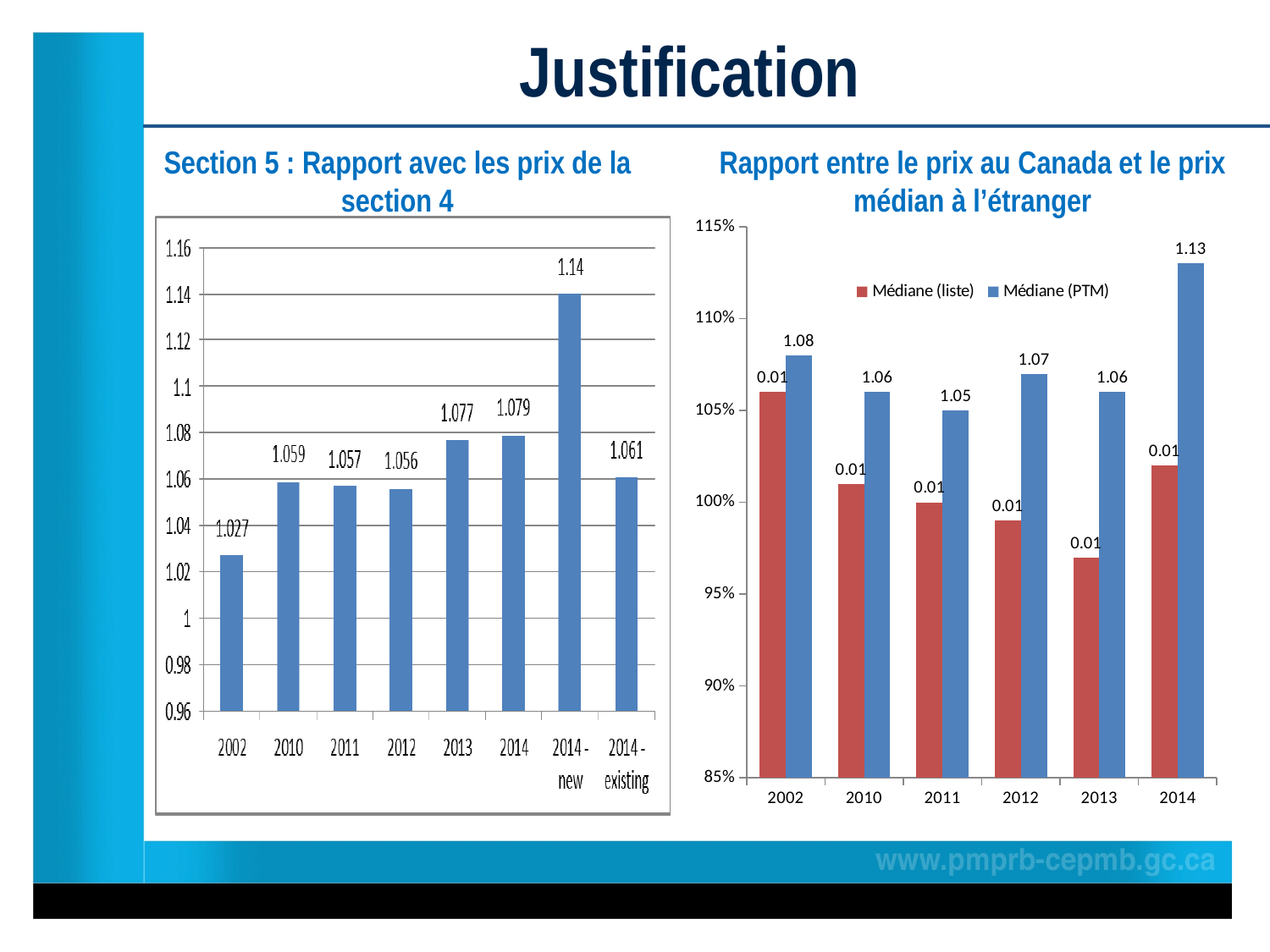
In the left chart 'Section 5 : Rapport avec les prix de la section 4', how many categories are shown on the x axis? 8 In the right chart 'Rapport entre le prix au Canada et le prix médian à l'étranger', is the Médiane (liste) bar for 2013 greater or less than 100%? less In the right chart 'Rapport entre le prix au Canada et le prix médian à l'étranger', what is the Médiane (PTM) value for 2011? 1.05 In the left chart 'Section 5 : Rapport avec les prix de la section 4', which category has the lowest value? 2002 In the right chart 'Rapport entre le prix au Canada et le prix médian à l'étranger', what is the Médiane (PTM) value for 2014? 1.13 In the right chart 'Rapport entre le prix au Canada et le prix médian à l'étranger', how many series does the legend list? 2 In the left chart 'Section 5 : Rapport avec les prix de la section 4', which category has the highest value? 2014 - new In the left chart 'Section 5 : Rapport avec les prix de la section 4', what is the difference between the values for 2014 - new and 2014 - existing? 0.079 In the left chart 'Section 5 : Rapport avec les prix de la section 4', what is the value for 2014 - existing? 1.061 In the left chart 'Section 5 : Rapport avec les prix de la section 4', what is the value for 2002? 1.027 What kind of chart is the right chart 'Rapport entre le prix au Canada et le prix médian à l'étranger'? Bar chart In the right chart 'Rapport entre le prix au Canada et le prix médian à l'étranger', which year has the highest Médiane (PTM) value? 2014